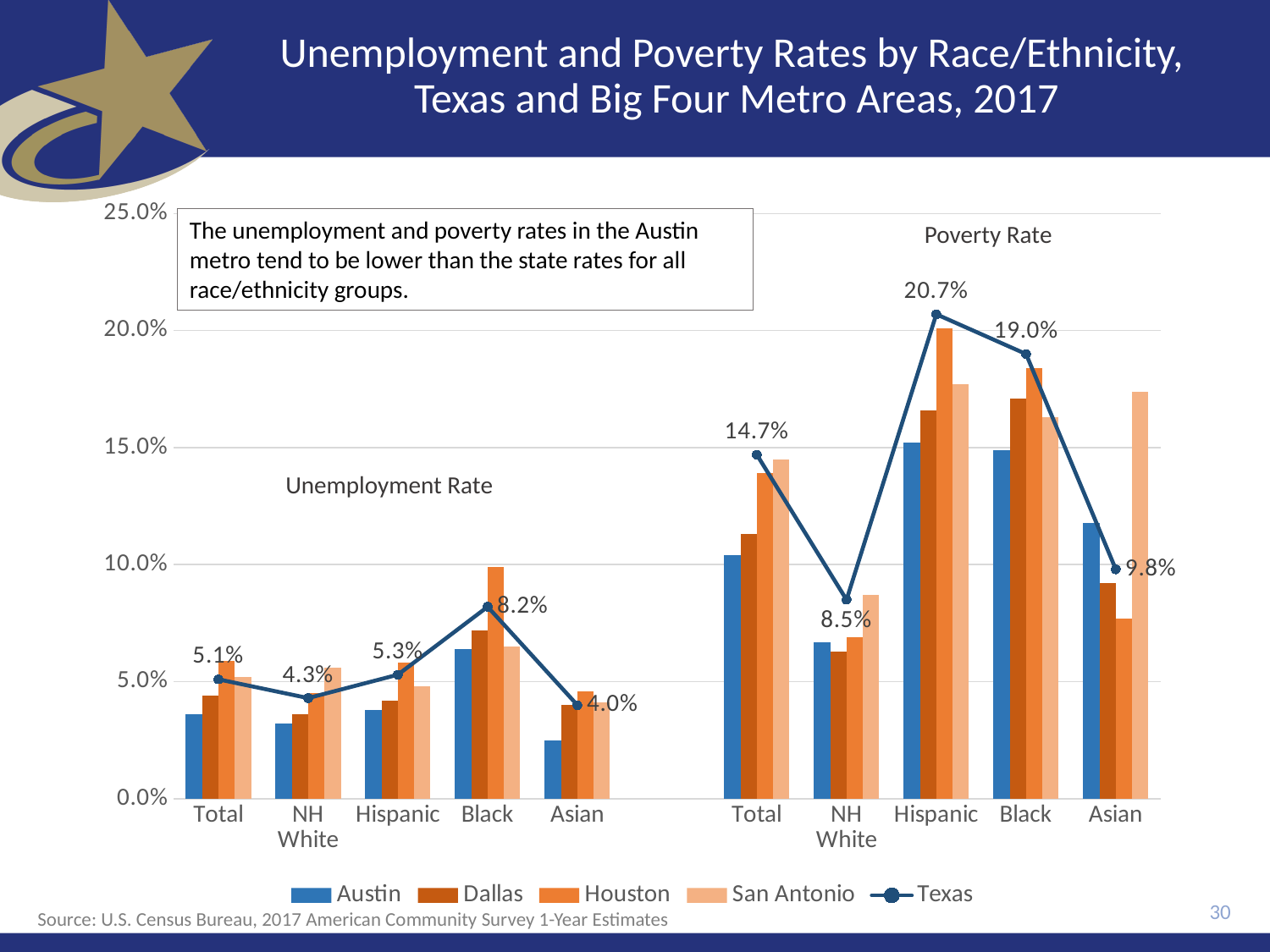
Among the Texas unemployment rate values, which race/ethnicity group has the lowest rate? Asian What is the Texas poverty rate for the Total category? 14.7% What is the Texas unemployment rate for Black residents? 8.2% What is the Texas poverty rate for Hispanic residents? 20.7% How many series does the legend list? 5 What is the Texas unemployment rate for Asian residents? 4.0% Among the Texas poverty rate values, which race/ethnicity group has the highest rate? Hispanic What is the difference between the Texas poverty rate for Hispanic residents (20.7%) and for Black residents (19.0%)? 1.7% Which is larger: the Texas unemployment rate for Hispanic residents or for NH White residents? Hispanic How many race/ethnicity categories are shown in the Poverty Rate section of the chart? 5 Which series is drawn as a line with markers rather than bars? Texas